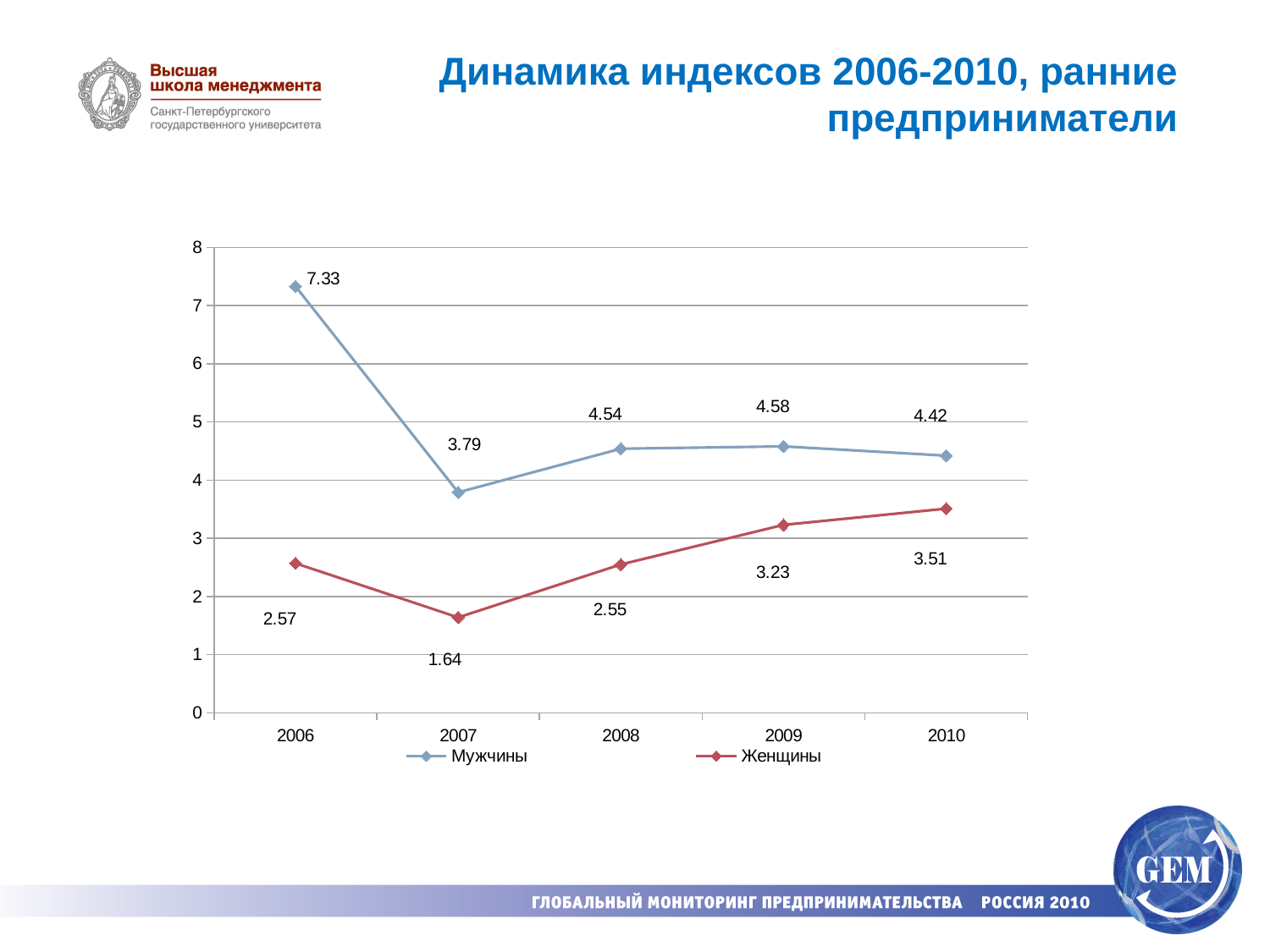
How many years are shown on the x axis? 5 What is the difference between the Мужчины and Женщины values in 2008? 1.99 What is the value for Женщины in 2009? 3.23 In which year is the value for Мужчины highest? 2006 What is the value for Мужчины in 2006? 7.33 Which series has the larger value in 2010, Мужчины or Женщины? Мужчины How many series does the legend list? 2 What is the value for Мужчины in 2010? 4.42 In which year is the value for Женщины lowest? 2007 What is the value for Женщины in 2007? 1.64 Is the value for Женщины in 2010 greater or less than 4? less What kind of chart is shown on the slide? line chart